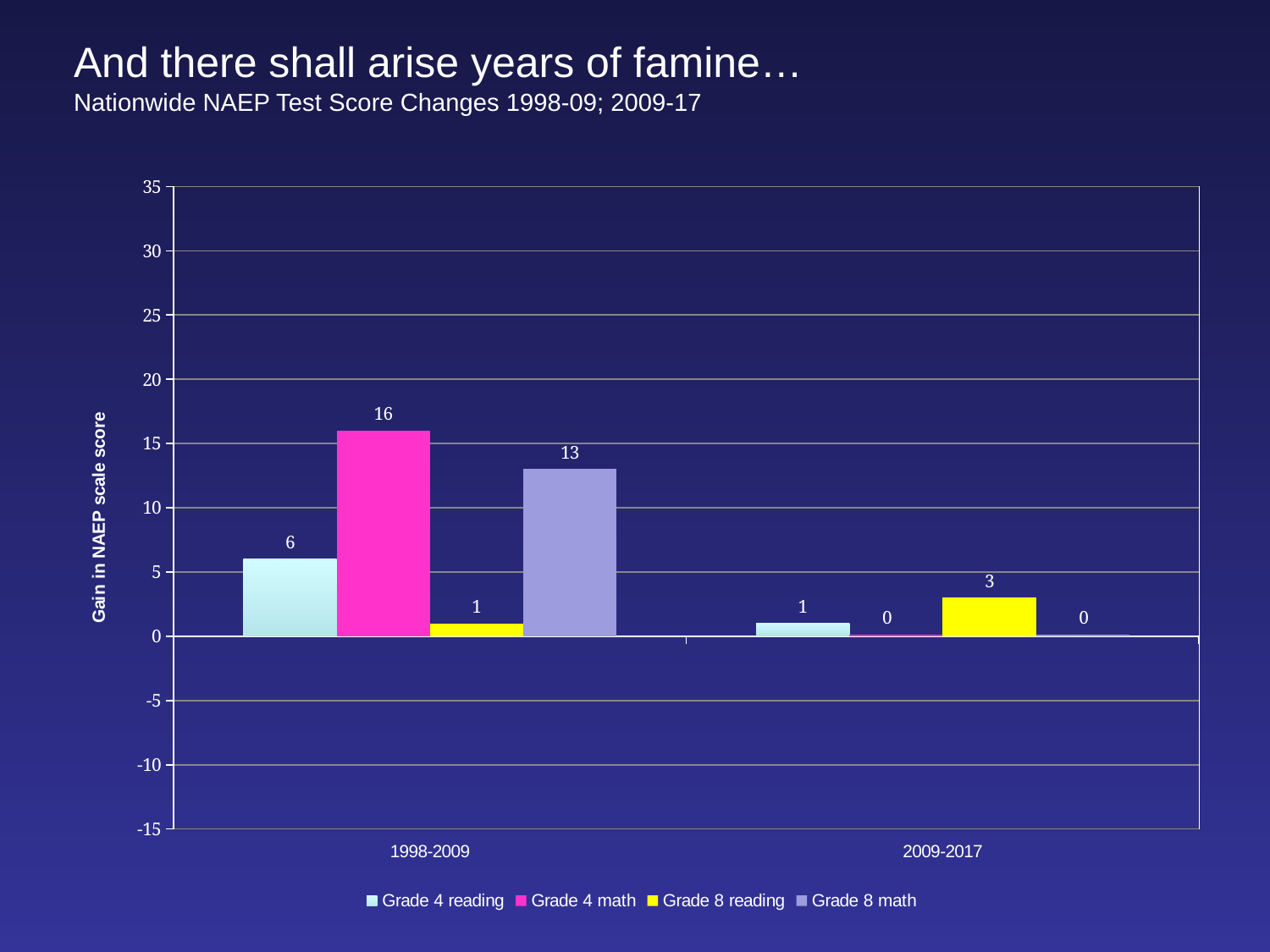
What kind of chart is shown on the slide? Bar chart Which series has the highest gain in the 1998-2009 period? Grade 4 math Which is larger: the Grade 8 math gain in 1998-2009 or the Grade 4 reading gain in 1998-2009? Grade 8 math gain in 1998-2009 Which series has the lowest gain in the 1998-2009 period? Grade 8 reading What is the difference between the Grade 4 math gain in 1998-2009 and in 2009-2017? 16 What is the gain in NAEP scale score for Grade 8 math in 2009-2017? 0 How many series does the legend list? 4 How many periods are shown on the x axis? 2 What is the label of the vertical axis? Gain in NAEP scale score What is the gain in NAEP scale score for Grade 8 reading in 2009-2017? 3 What is the gain in NAEP scale score for Grade 4 reading in 1998-2009? 6 What is the gain in NAEP scale score for Grade 4 math in 1998-2009? 16